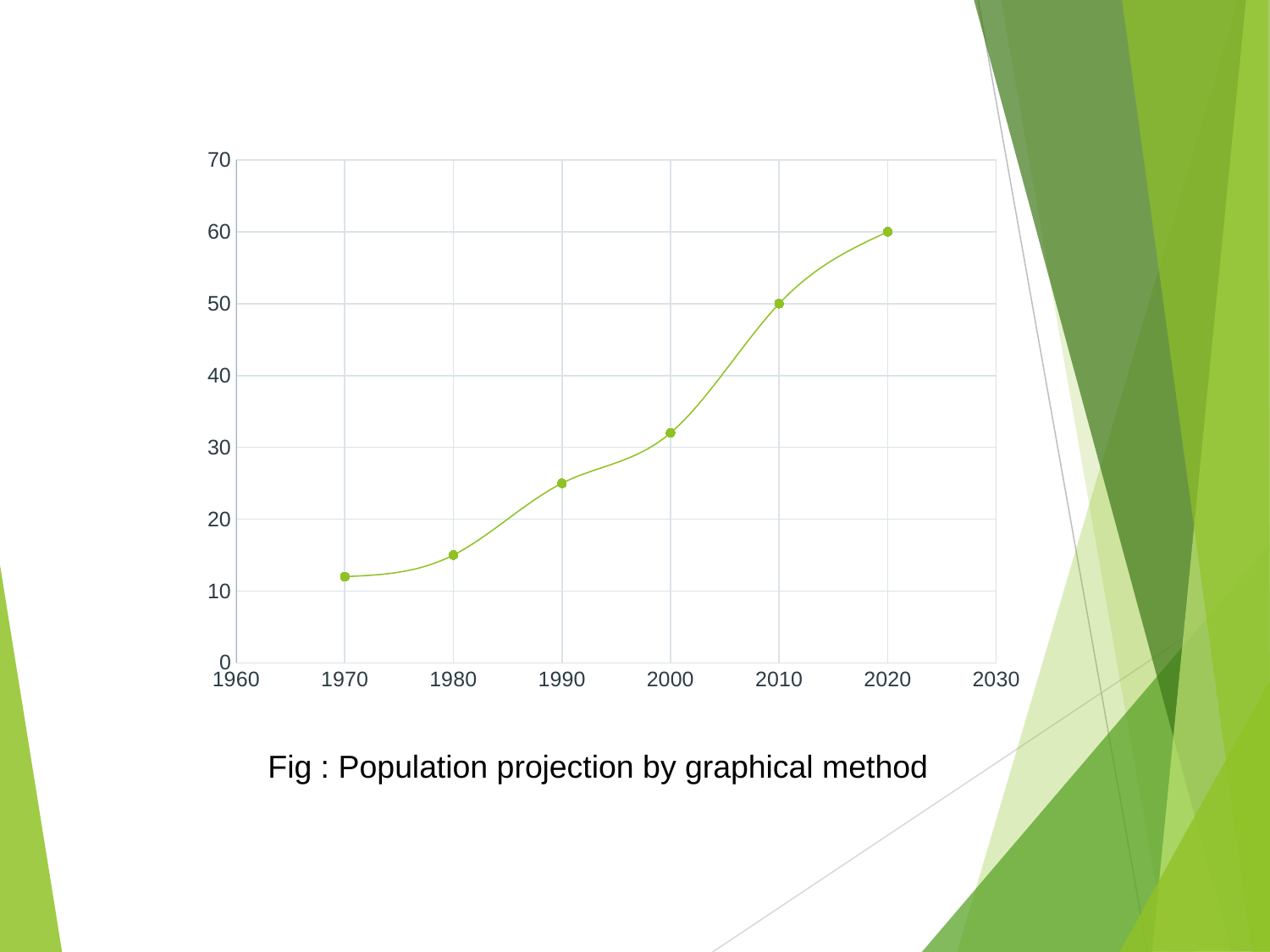
What is the value plotted for 2010? 50 Is the value for 1990 greater or less than 30? less What is the caption given below the chart? Fig : Population projection by graphical method What kind of chart is shown on the slide? line chart Which has the larger value, 1990 or 2010? 2010 Is the value for 1980 greater or less than 20? less What is the difference between the values for 2020 and 2010? 10 Which year has the highest plotted value? 2020 What is the value plotted for 2020? 60 How many data points are plotted on the chart? 6 Do the values rise or fall from 1970 to 2020? rise Which year has the lowest plotted value? 1970